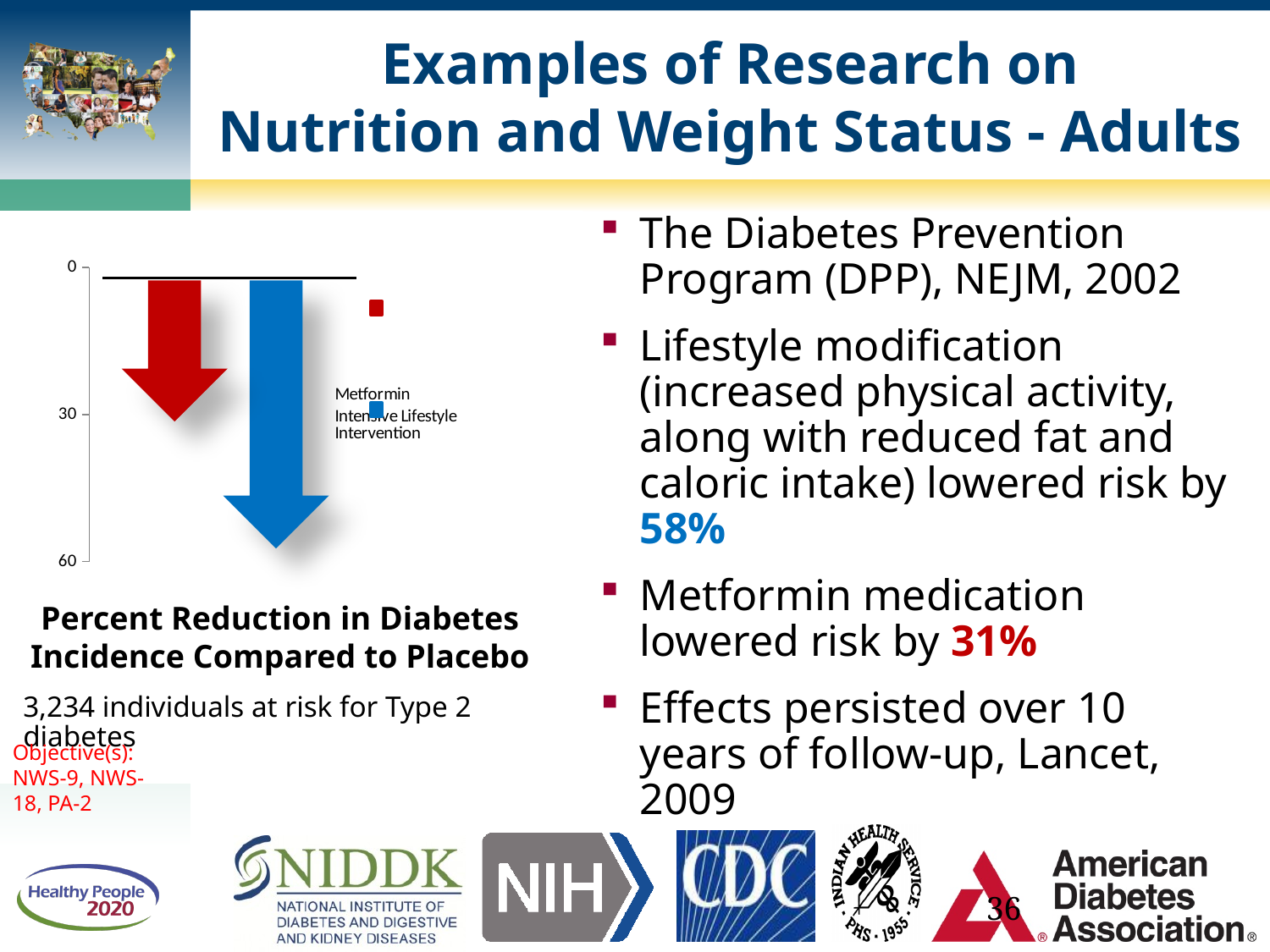
Which series has the lowest percent reduction in diabetes incidence? Metformin Is the value for Metformin greater or less than 60? less Is the value for Intensive Lifestyle Intervention greater or less than 60? less How many series are plotted in the chart? 2 Is the value for Intensive Lifestyle Intervention greater or less than 30? greater Which series shows the larger percent reduction in diabetes incidence, Metformin or Intensive Lifestyle Intervention? Intensive Lifestyle Intervention What is the title of the chart on the slide? Percent Reduction in Diabetes Incidence Compared to Placebo How many series does the chart's legend list? 2 Which series has the highest percent reduction in diabetes incidence? Intensive Lifestyle Intervention What colour is used for the Metformin series in the chart? Red